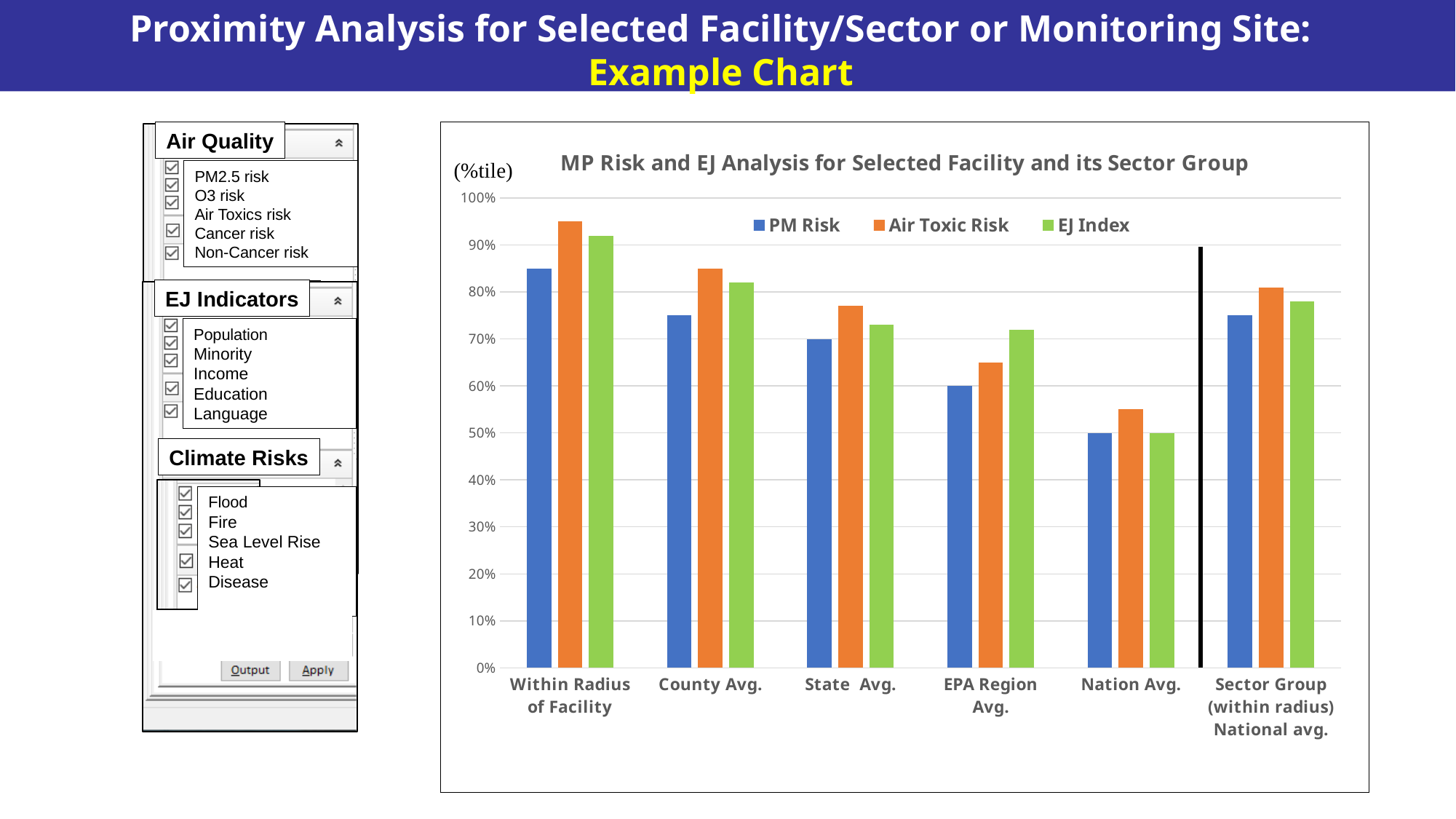
For which category is the PM Risk bar the lowest? Nation Avg. What is the title of the chart? MP Risk and EJ Analysis for Selected Facility and its Sector Group Is the Air Toxic Risk value for Nation Avg. greater or less than 60%? less Which is larger, the EJ Index value for EPA Region Avg. or for Nation Avg.? EPA Region Avg. Which series is shown in orange in the chart? Air Toxic Risk How many series does the chart legend list? 3 What type of chart is shown on the slide? bar chart For which category is the Air Toxic Risk bar the highest? Within Radius of Facility Which is larger, the PM Risk value for Within Radius of Facility or for County Avg.? Within Radius of Facility Do the PM Risk values rise or fall from Within Radius of Facility to Nation Avg.? fall How many categories are shown along the x axis of the chart? 6 Is the Air Toxic Risk value for Within Radius of Facility greater or less than 90%? greater